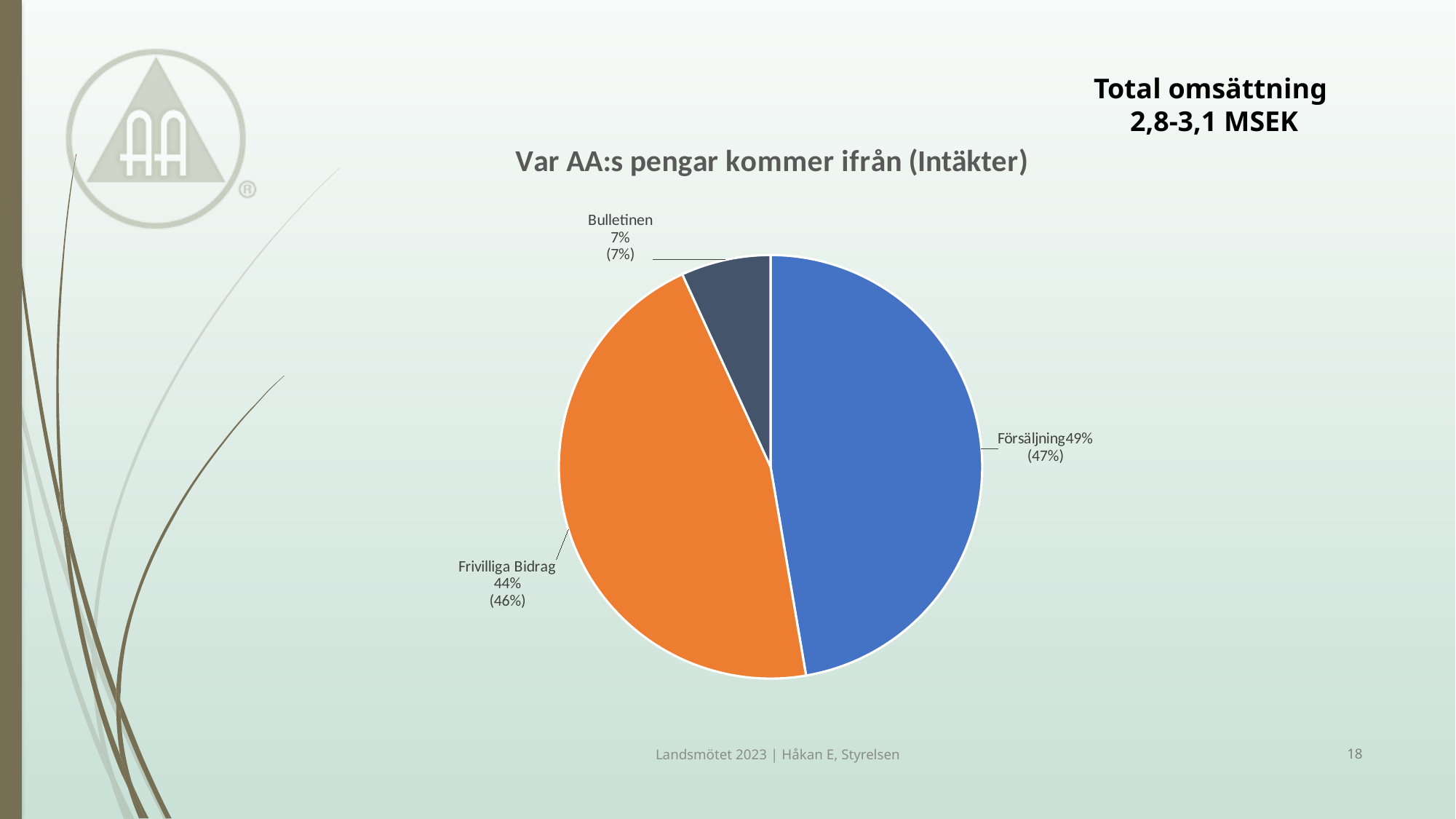
Which is larger, the share for Frivilliga Bidrag or the share for Bulletinen? Frivilliga Bidrag What is the title of the chart? Var AA:s pengar kommer ifrån (Intäkter) What share of the pie does Bulletinen have? 7% What share of the pie does Försäljning have? 49% Which category has the largest slice of the pie? Försäljning What share of the pie does Frivilliga Bidrag have? 44% What is the difference in percentage points between Försäljning and Frivilliga Bidrag? 5 percentage points What value is shown in parentheses for Försäljning? (47%) What is the difference in percentage points between Frivilliga Bidrag and Bulletinen? 37 percentage points Which category has the smallest slice of the pie? Bulletinen What kind of chart is shown on the slide? pie chart How many slices does the pie chart have? 3